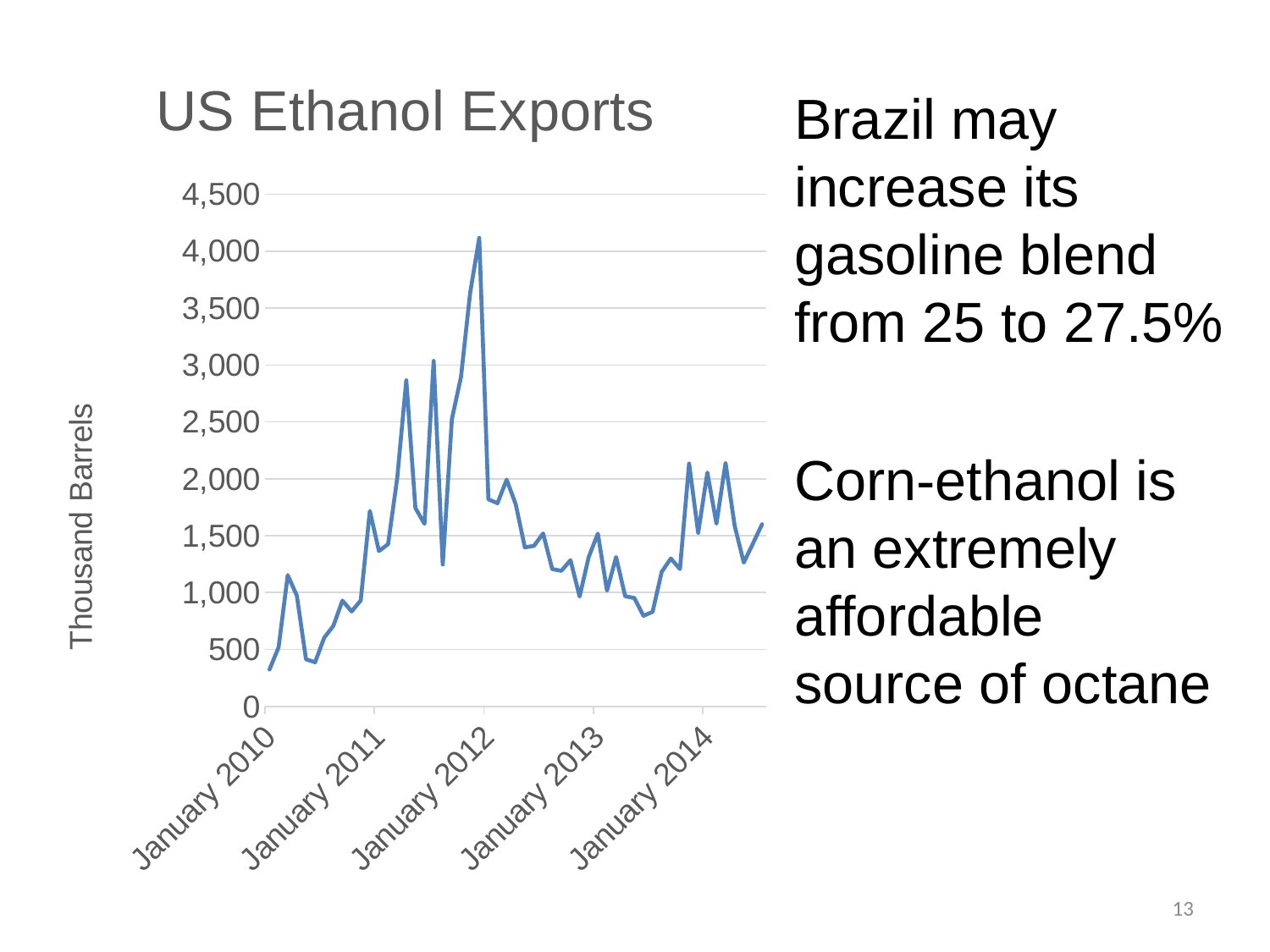
What kind of chart is shown on the slide? line chart Which is larger: the value at January 2010 or the peak value just before January 2012? the peak just before January 2012 Is the value at January 2011 greater or less than 500? greater Is the lowest value reached during 2013 greater or less than 1,000? less What is the label on the vertical axis of the chart? Thousand Barrels What is the highest value marked on the vertical axis? 4,500 What is the title of the chart? US Ethanol Exports Is the highest value on the line, reached shortly before January 2012, greater or less than 3,500? greater Overall, do the values rise or fall from January 2010 to the peak near January 2012? rise How many year labels are shown on the horizontal axis? 5 Overall, do the values rise or fall from the peak near January 2012 to mid-2013? fall